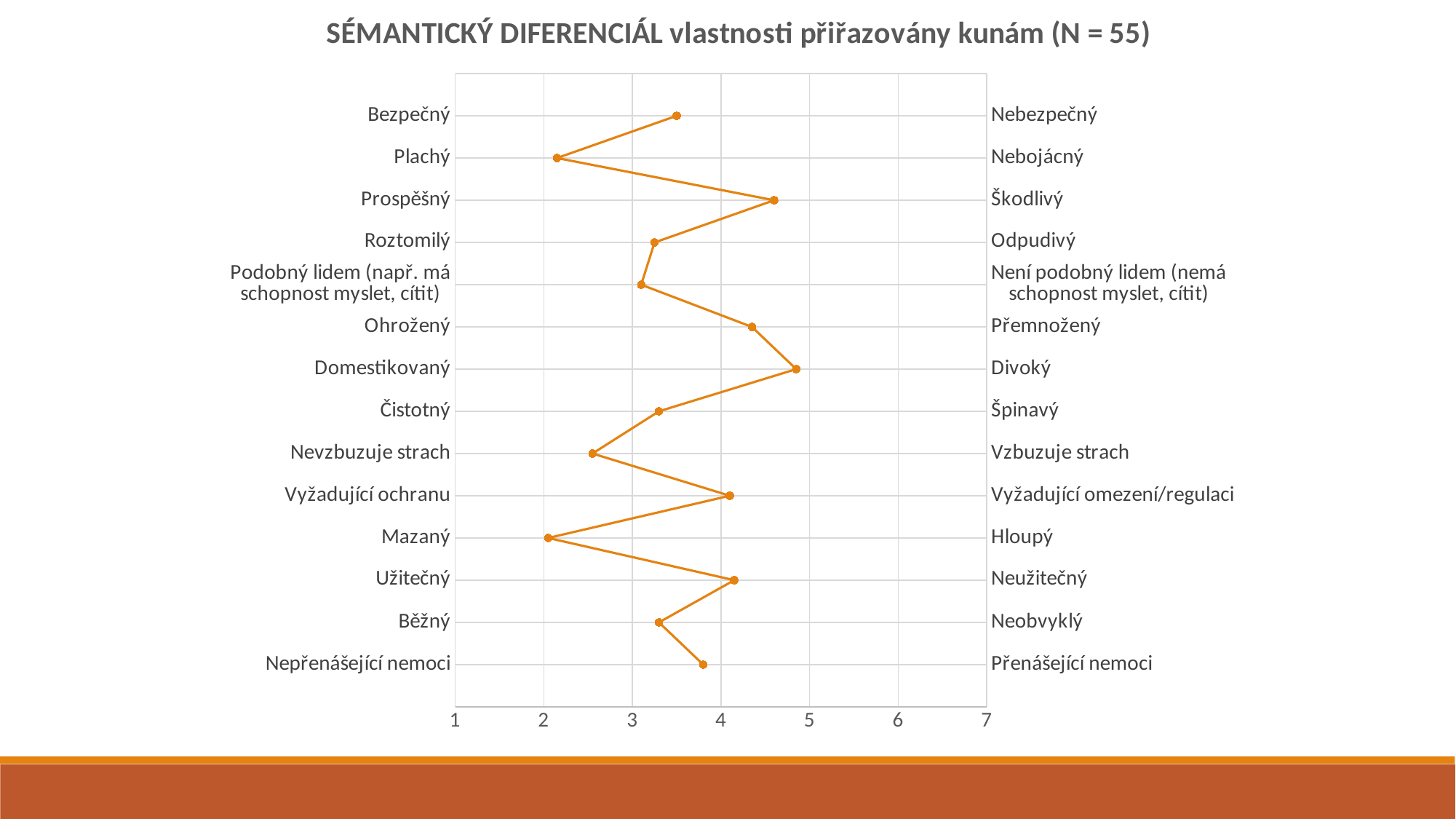
What kind of chart is shown on the slide? line chart Is the value for Nevzbuzuje strach – Vzbuzuje strach greater or less than 3? less Is the value for Plachý – Nebojácný greater or less than 3? less Which category has the highest plotted value? Domestikovaný – Divoký Is the value for Mazaný – Hloupý greater or less than 3? less Which has the larger value: Vyžadující ochranu – Vyžadující omezení/regulaci or Nevzbuzuje strach – Vzbuzuje strach? Vyžadující ochranu – Vyžadující omezení/regulaci How many attribute pairs (categories) are plotted on the chart? 14 What sample size (N) is stated in the chart title? 55 Which has the larger value: Prospěšný – Škodlivý or Roztomilý – Odpudivý? Prospěšný – Škodlivý